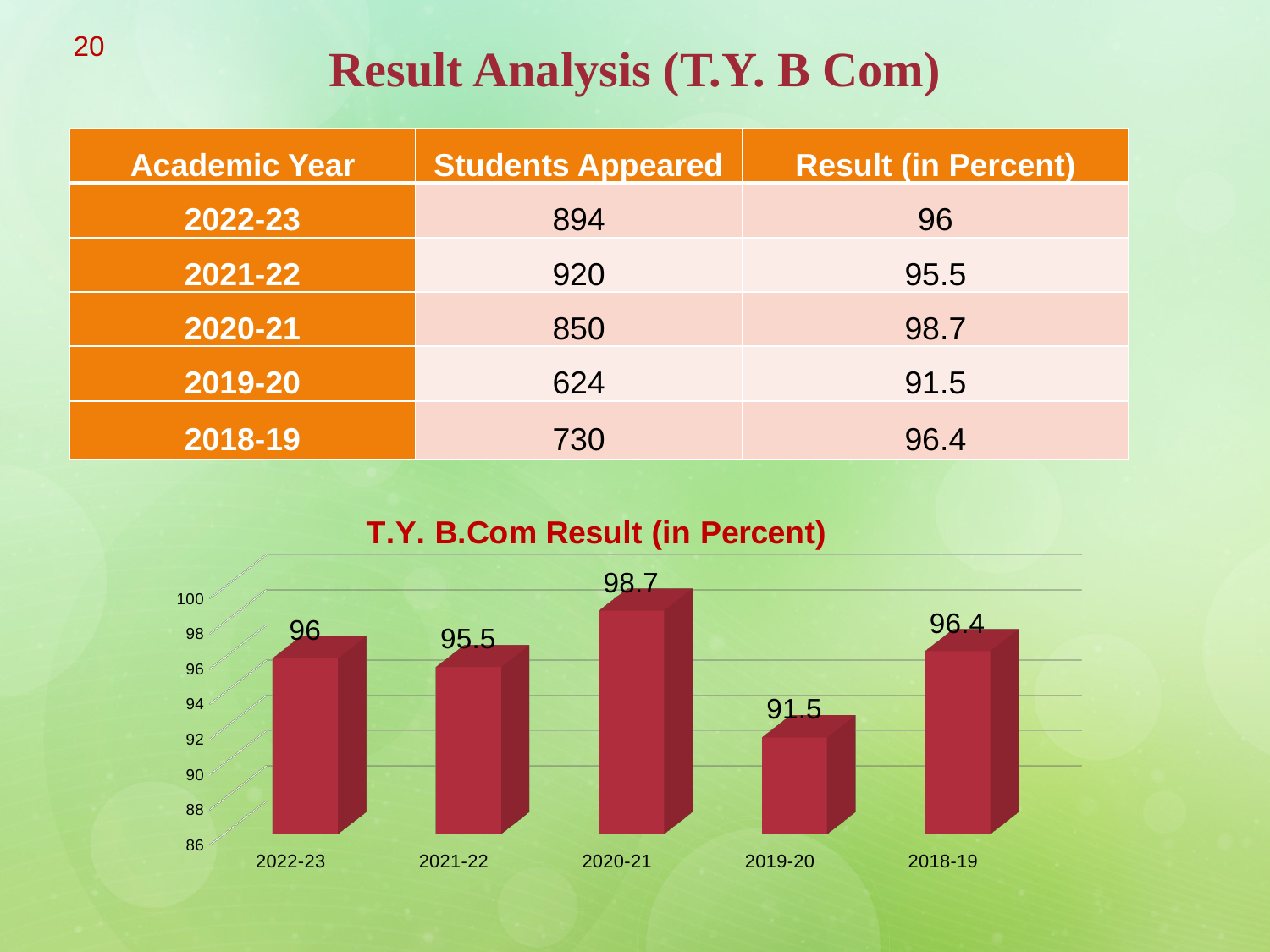
What is the title of the chart? T.Y. B.Com Result (in Percent) Which academic year has the lowest result in the chart? 2019-20 Which has a higher result, 2022-23 or 2021-22? 2022-23 Which academic year has the highest result in the chart? 2020-21 Is the value for 2019-20 greater or less than 94? less What kind of chart is shown on the slide? bar chart How many academic years are shown in the chart? 5 What is the result (in percent) for 2019-20 in the chart? 91.5 What is the difference between the result for 2022-23 and the result for 2021-22? 0.5 What is the result (in percent) for 2018-19 in the chart? 96.4 What is the difference between the result for 2020-21 and the result for 2019-20? 7.2 What is the result (in percent) for 2020-21 in the chart? 98.7